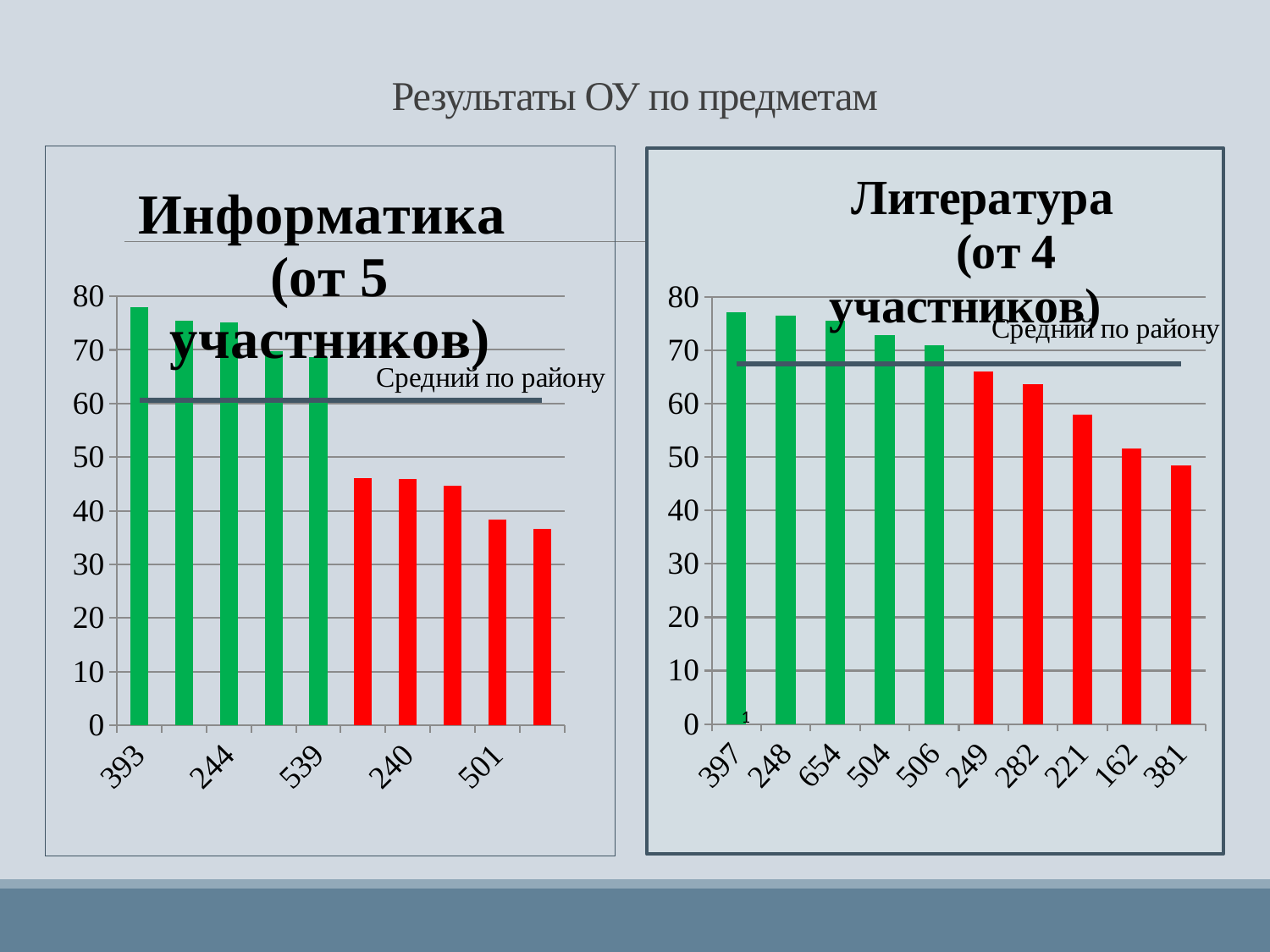
In the Литература (от 4 участников) chart, is the value for 381 greater or less than 50? less In the Информатика (от 5 участников) chart, which labelled category has the highest value? 393 In the Литература (от 4 участников) chart, how many bars are plotted? 10 In the Литература (от 4 участников) chart, do the values rise or fall from left to right along the x axis? fall In the Литература (от 4 участников) chart, which is larger, the value for 397 or the value for 381? 397 In the Информатика (от 5 участников) chart, is the value for 393 greater or less than 70? greater In the Литература (от 4 участников) chart, is the value for 249 greater or less than 60? greater What does the horizontal line drawn across the Информатика (от 5 участников) chart represent, according to its label? Средний по району What kind of chart is the Информатика (от 5 участников) chart? bar chart In the Литература (от 4 участников) chart, which category has the lowest value? 381